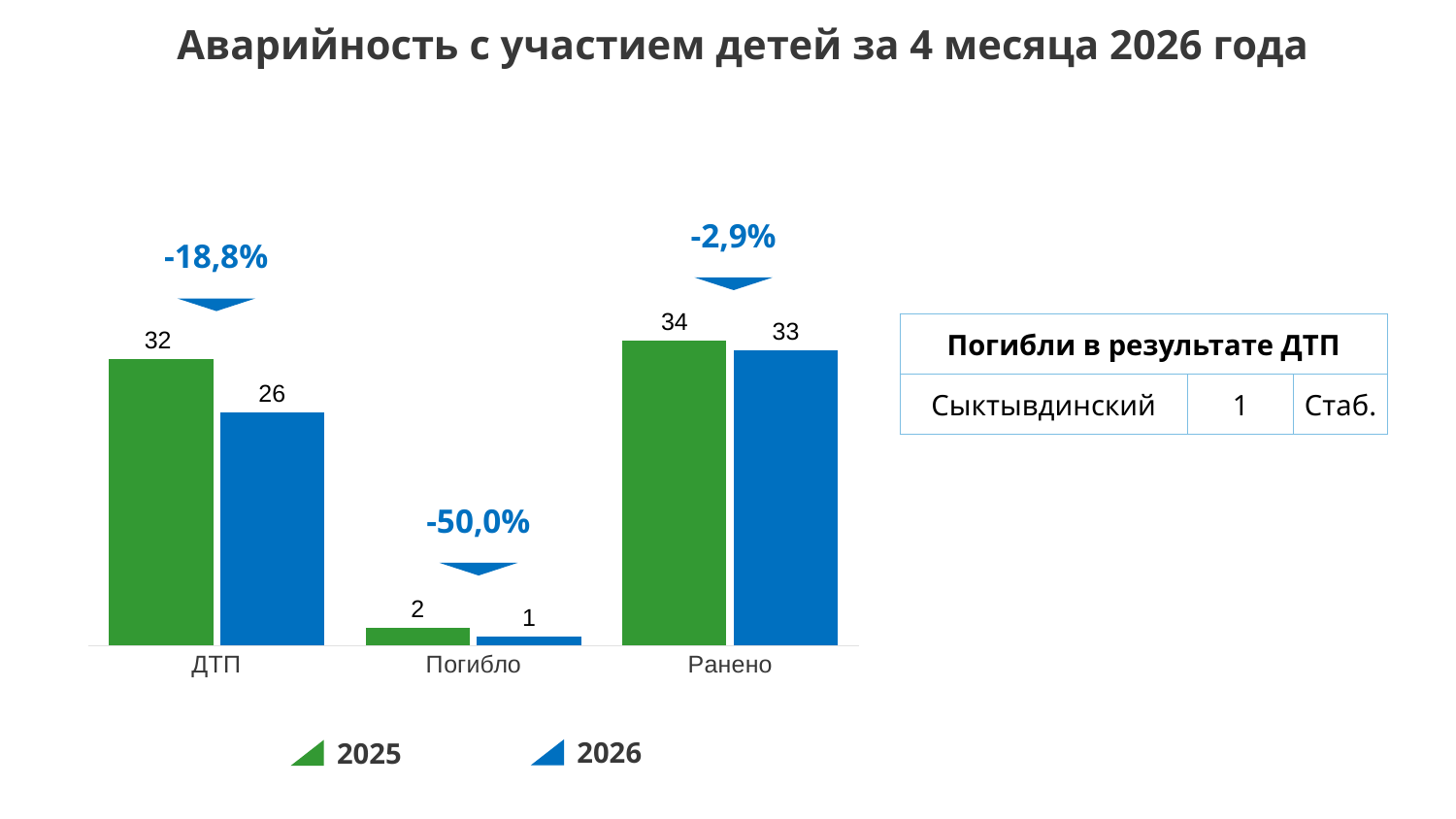
What is the value for ДТП in the 2026 series? 26 How many categories are shown on the x axis? 3 What kind of chart is shown on the slide? bar chart What is the value for Погибло in the 2025 series? 2 Which is larger for Ранено: the 2025 value or the 2026 value? 2025 What is the difference between the 2025 and 2026 values for ДТП? 6 Which category has the highest value in the 2025 series? Ранено What is the value for Ранено in the 2026 series? 33 Which category has the lowest value in the 2026 series? Погибло What is the value for ДТП in the 2025 series? 32 How many series does the legend list? 2 What percentage change is shown above the Погибло bars? -50,0%